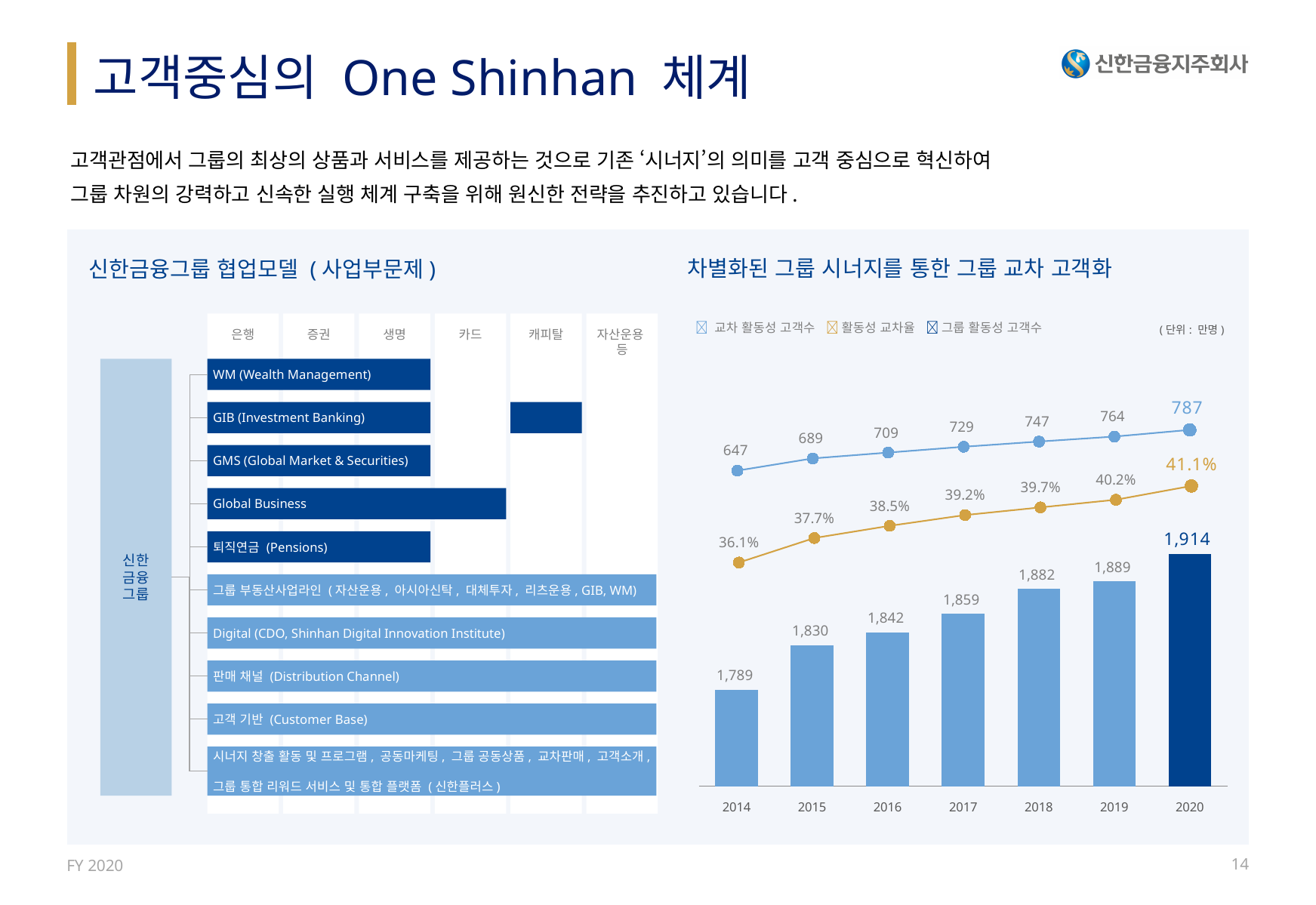
What is the difference in 교차 활동성 고객수 between 2019 and 2018? 17 What is the 교차 활동성 고객수 value for 2018? 747 Which year has the highest 그룹 활동성 고객수? 2020 How many series does the chart legend list? 3 Which year has the lowest 활동성 교차율? 2014 Which is larger, the 그룹 활동성 고객수 for 2016 or for 2017? 2017 What is the 교차 활동성 고객수 value for 2014? 647 Does the 활동성 교차율 rise or fall from 2014 to 2020? rise How many years are shown on the x axis of the chart? 7 What is the 활동성 교차율 for 2017? 39.2% What is the value of 그룹 활동성 고객수 for 2020? 1,914 What is the difference in 그룹 활동성 고객수 between 2020 and 2014? 125